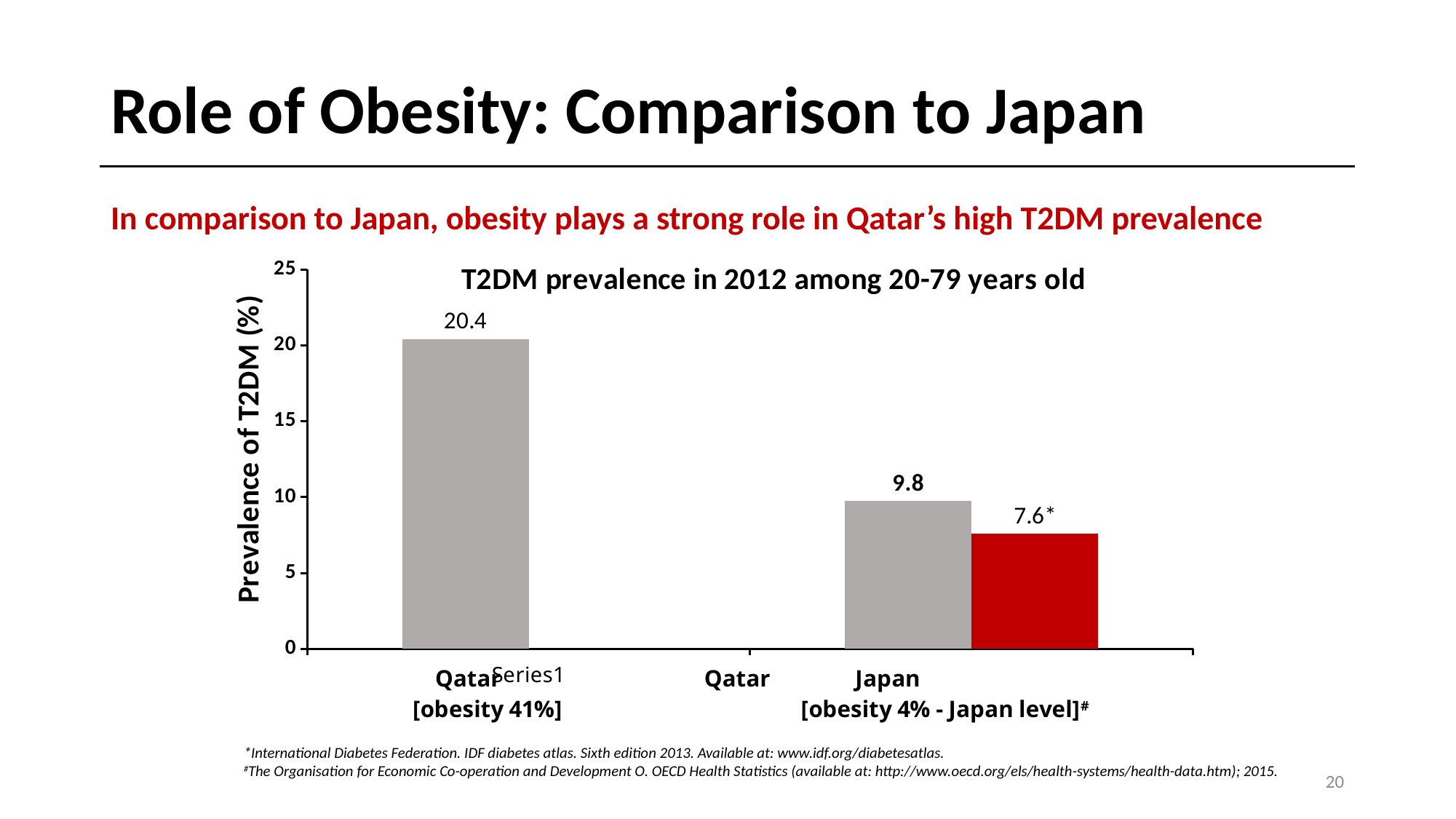
What value is printed above the middle grey bar? 9.8 What is the difference between the 20.4 bar and the 9.8 bar? 10.6 How many bars are plotted in the chart? 3 Which bar has the lowest value in the chart? the red bar (7.6*) What is the T2DM prevalence value shown for the leftmost bar, Qatar [obesity 41%]? 20.4 Which bar has the highest value in the chart? Qatar [obesity 41%] What kind of chart is shown on the slide? bar chart What is the label of the y axis? Prevalence of T2DM (%) What value is printed above the red bar? 7.6* What is the title of the chart? T2DM prevalence in 2012 among 20-79 years old Which is larger, the value of the middle grey bar or the red bar? the middle grey bar (9.8) Is the value for Qatar [obesity 41%] greater or less than 20? greater